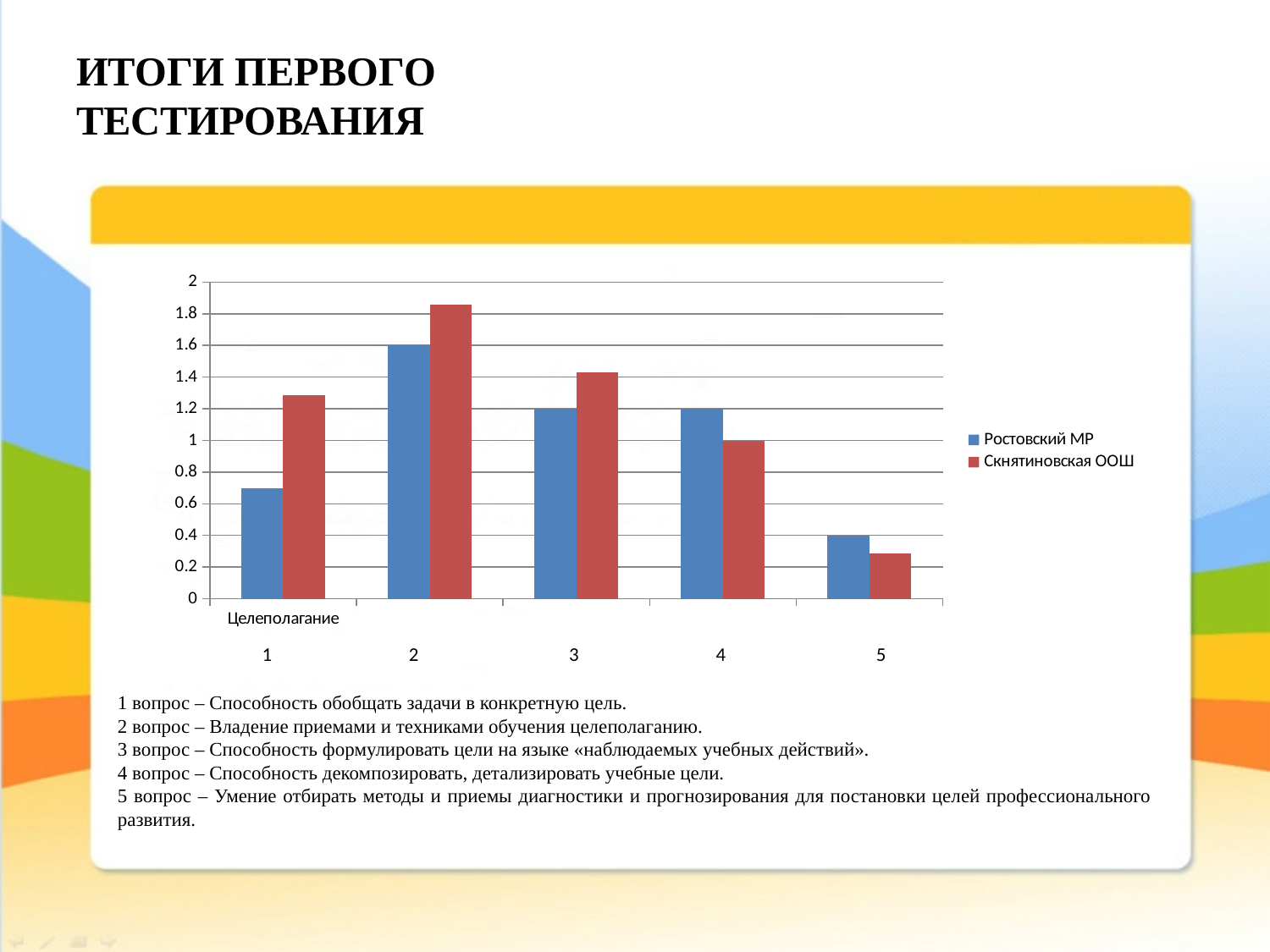
For which question is the value for Скнятиновская ООШ highest? 2 What kind of chart is shown on the slide? bar chart How many series does the legend list? 2 For which question is the value for Ростовский МР lowest? 5 How many question categories are plotted along the x axis? 5 Which series is shown in red in the legend? Скнятиновская ООШ What is the value for Ростовский МР for question 5? 0.4 Is the value for Скнятиновская ООШ for question 2 greater or less than 1.6? greater For question 4, which series has the larger value, Ростовский МР or Скнятиновская ООШ? Ростовский МР What is the value for Скнятиновская ООШ for question 4? 1 What is the difference between the Ростовский МР values for question 2 and question 5? 1.2 What is the value for Ростовский МР for question 2? 1.6